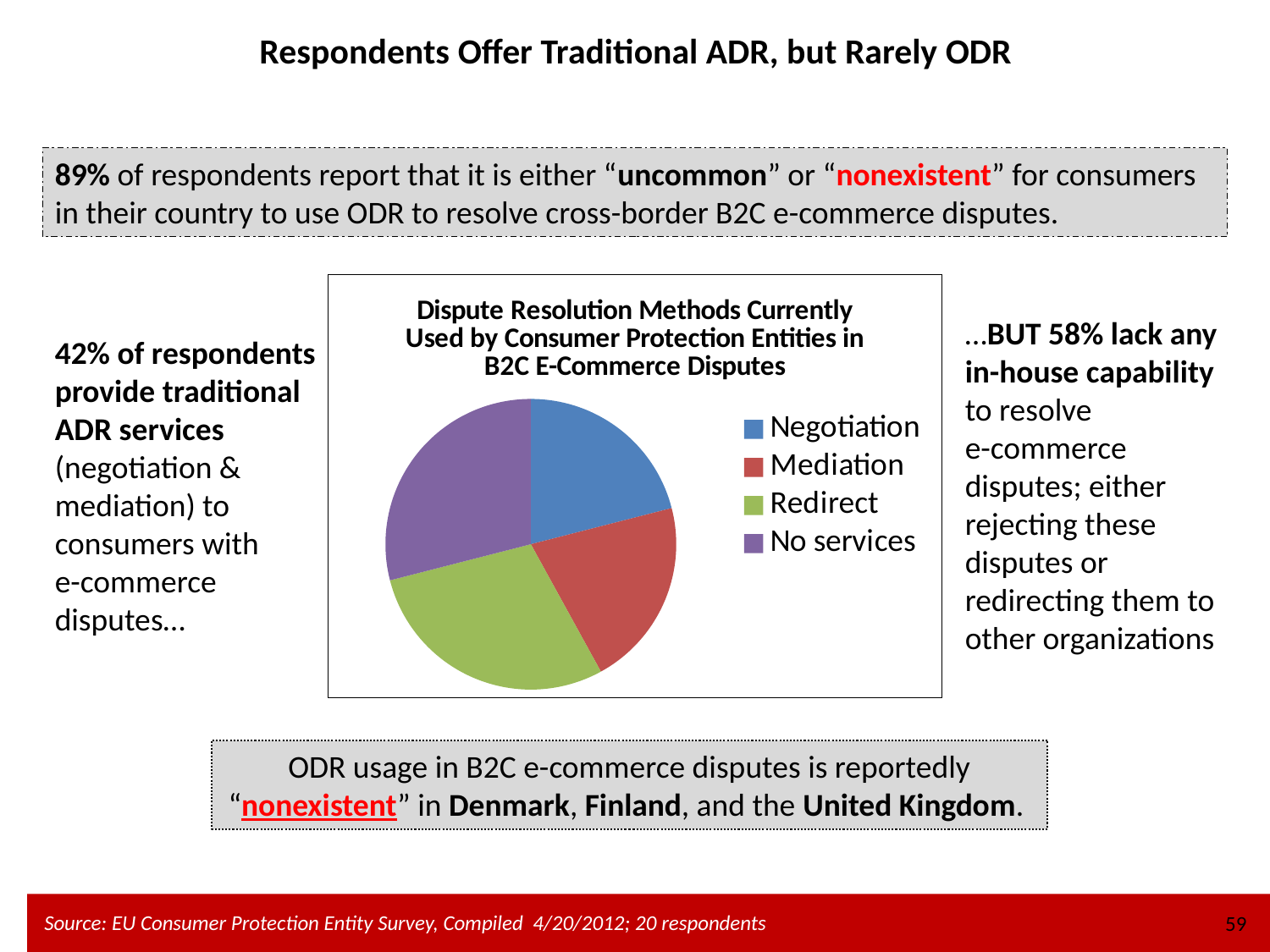
What kind of chart is shown on the slide? pie chart Which slice is larger in the pie chart, No services or Mediation? No services Which colour represents the No services slice in the pie chart? purple How many slices does the pie chart have? 4 Which slice is larger in the pie chart, Redirect or Mediation? Redirect How many entries does the legend of the pie chart list? 4 What is the title of the pie chart? Dispute Resolution Methods Currently Used by Consumer Protection Entities in B2C E-Commerce Disputes